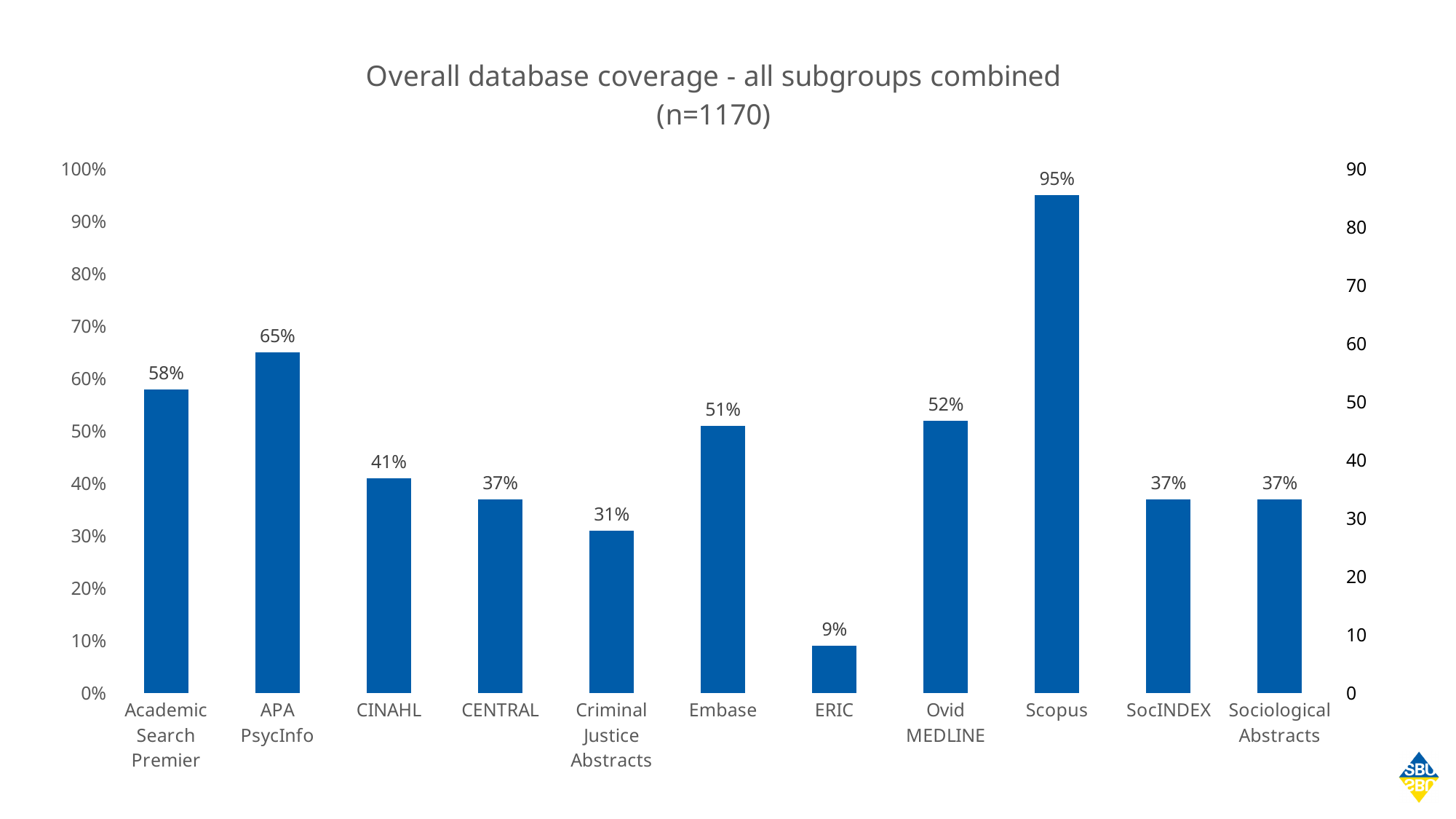
What is the coverage value for APA PsycInfo? 65% What kind of chart is this? Bar chart What is the title of the chart? Overall database coverage - all subgroups combined (n=1170) What is the coverage value for Scopus? 95% What is the difference between the coverage of Scopus and ERIC? 86% What is the coverage value for Criminal Justice Abstracts? 31% Which database has the lowest coverage? ERIC What is the coverage value for Ovid MEDLINE? 52% How many databases are shown on the chart? 11 Which has higher coverage, Embase or CINAHL? Embase Which database has the highest coverage? Scopus What is the difference between the coverage of APA PsycInfo and Academic Search Premier? 7%